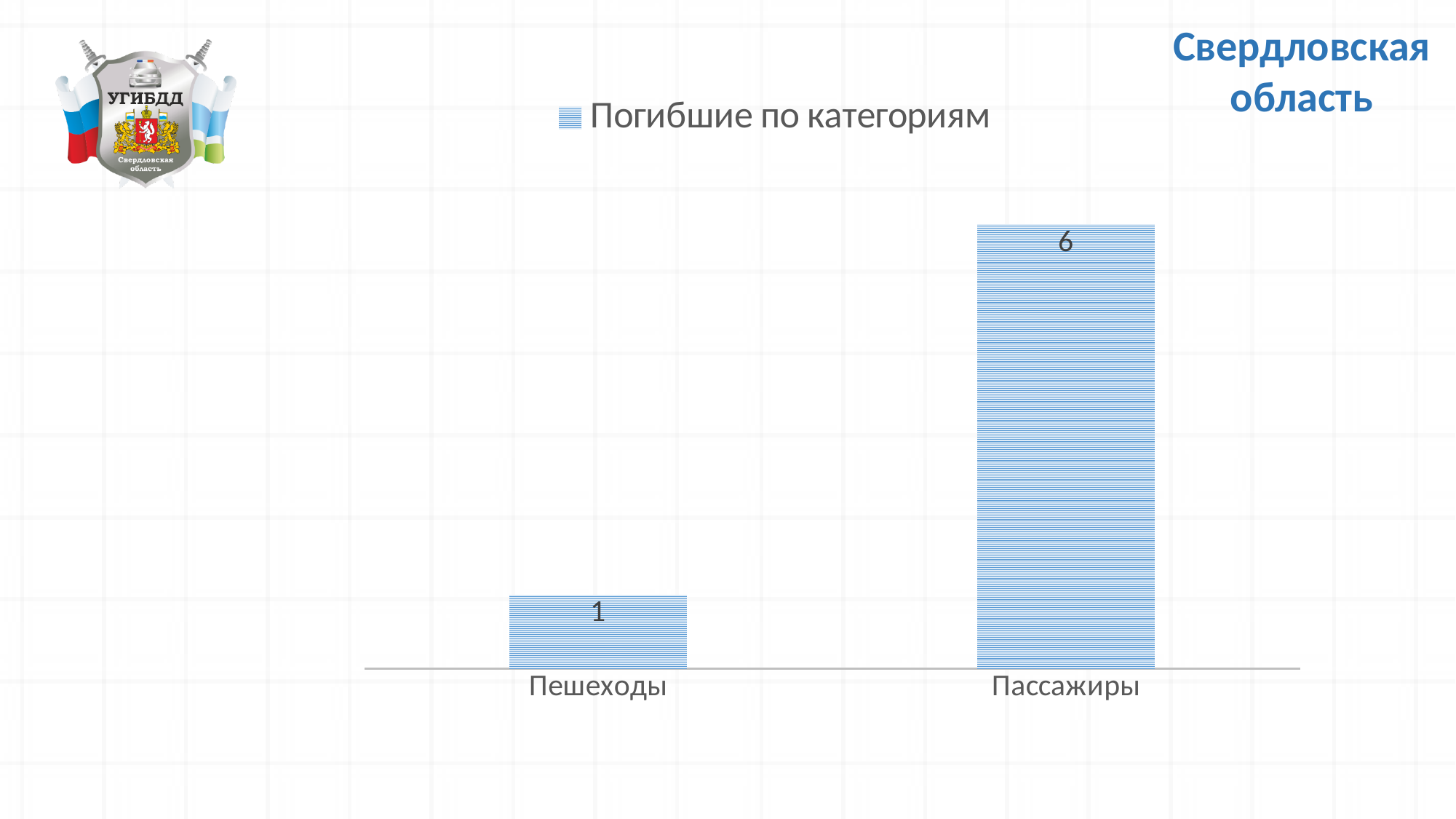
What is the total of the values for Пешеходы and Пассажиры? 7 Which is larger, the value for Пешеходы or the value for Пассажиры? Пассажиры What is the name of the series shown in the legend? Погибшие по категориям What is the difference between the values for Пассажиры and Пешеходы? 5 How many categories are shown on the chart? 2 Which category has the lowest value? Пешеходы Which category has the highest value? Пассажиры What kind of chart is shown on the slide? bar chart Do the values rise or fall from Пешеходы to Пассажиры? rise What is the value for Пешеходы? 1 How many series does the legend list? 1 What is the value for Пассажиры? 6